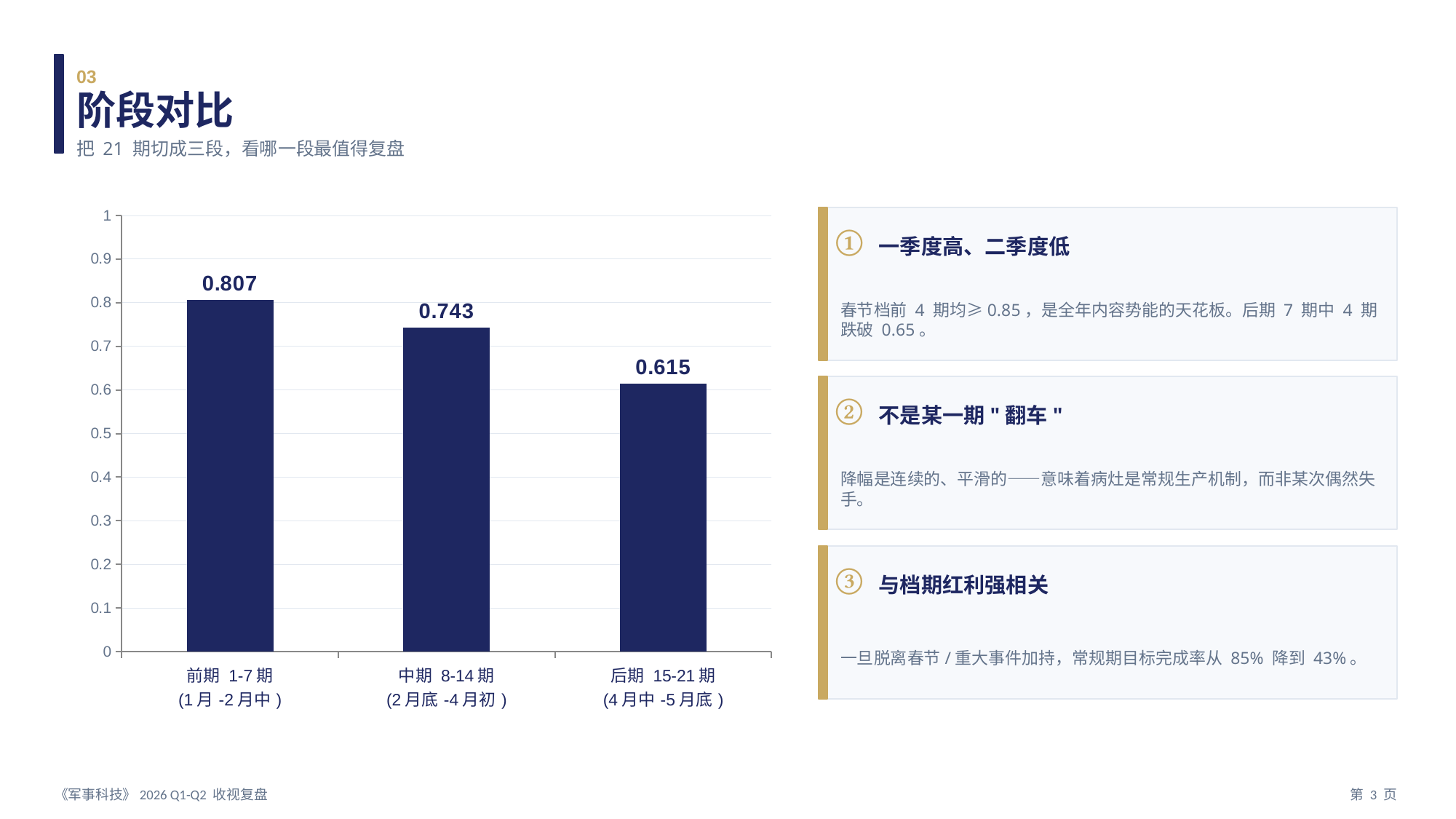
What kind of chart is shown on the slide? bar chart What is the value for 后期 15-21期? 0.615 What is the difference between the values for 中期 8-14期 and 后期 15-21期? 0.128 How many categories are shown in the chart? 3 Do the values rise or fall from left to right across the categories? fall What is the difference between the values for 前期 1-7期 and 后期 15-21期? 0.192 Which category has the highest value? 前期 1-7期 What is the value for 中期 8-14期? 0.743 What is the value for 前期 1-7期? 0.807 Which is larger, the value for 前期 1-7期 or 中期 8-14期? 前期 1-7期 Which category has the lowest value? 后期 15-21期 Is the value for 后期 15-21期 greater or less than 0.7? less